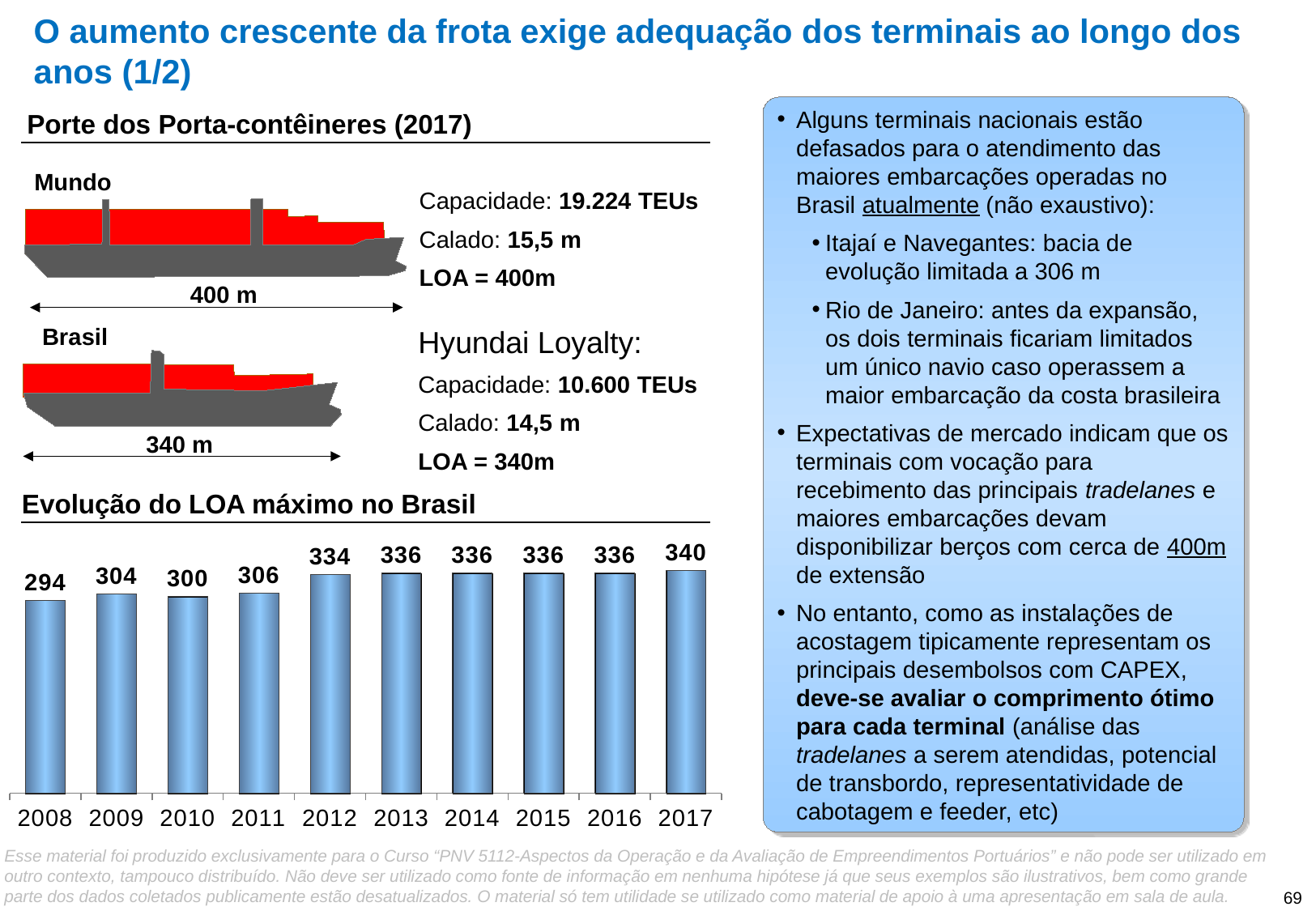
How many years are shown in the 'Evolução do LOA máximo no Brasil' chart? 10 What kind of chart is 'Evolução do LOA máximo no Brasil'? bar chart Do the values in the 'Evolução do LOA máximo no Brasil' chart generally rise or fall from 2008 to 2017? rise What is the difference between the values for 2017 and 2008 in the 'Evolução do LOA máximo no Brasil' chart? 46 What is the value for 2012 in the 'Evolução do LOA máximo no Brasil' chart? 334 In the 'Evolução do LOA máximo no Brasil' chart, which is larger, the value for 2009 or the value for 2010? 2009 What is the difference between the values for 2012 and 2011 in the 'Evolução do LOA máximo no Brasil' chart? 28 Which year has the highest value in the 'Evolução do LOA máximo no Brasil' chart? 2017 How many years in the 'Evolução do LOA máximo no Brasil' chart have a value of 336? 4 What is the value for 2017 in the 'Evolução do LOA máximo no Brasil' chart? 340 Which year has the lowest value in the 'Evolução do LOA máximo no Brasil' chart? 2008 What is the value for 2008 in the 'Evolução do LOA máximo no Brasil' chart? 294